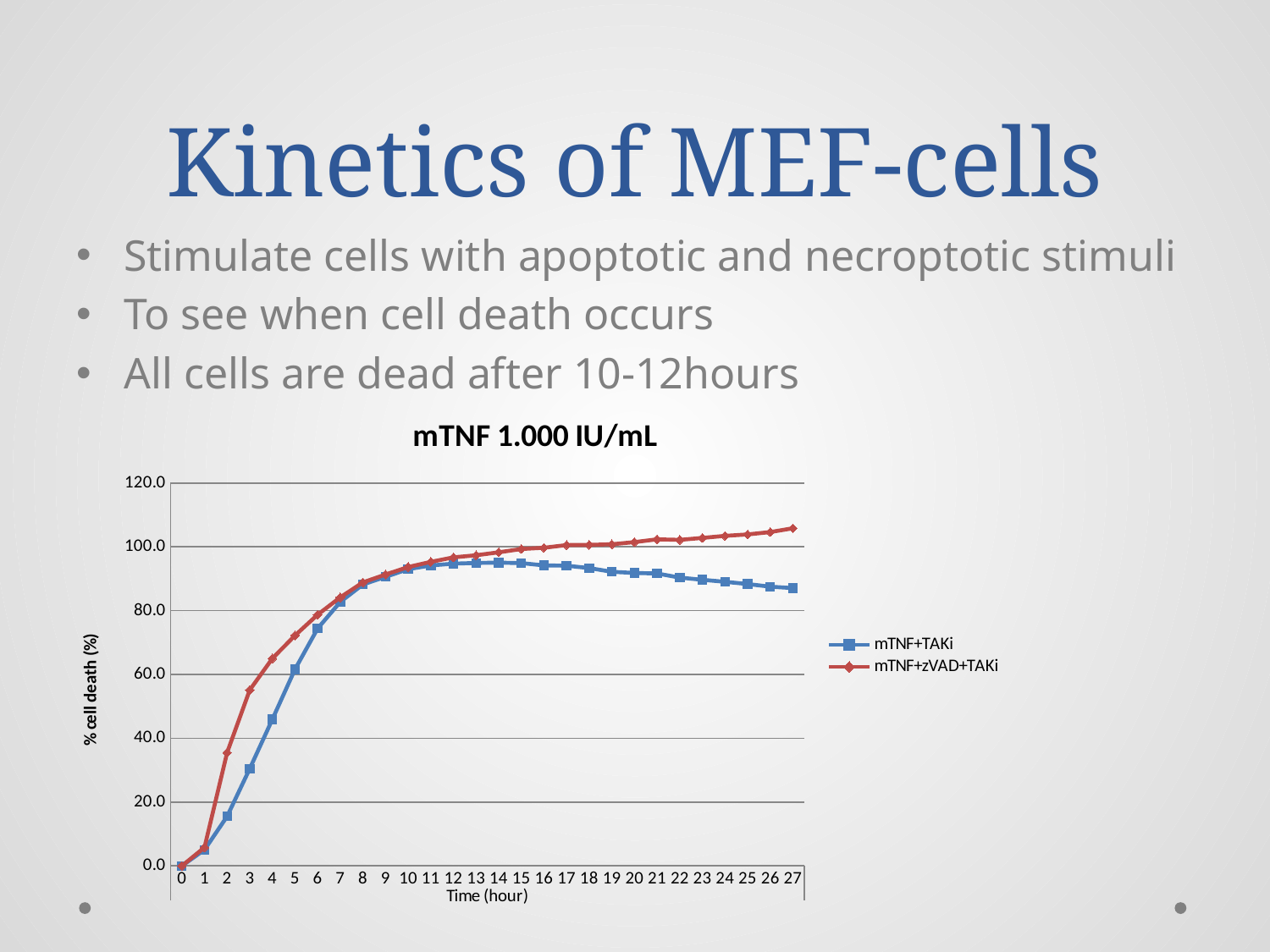
What is the label of the y axis? % cell death (%) What is the title of the chart? mTNF 1.000 IU/mL What kind of chart is shown on the slide? line chart Is the value for mTNF+TAKi at hour 27 greater or less than 100.0? less At hour 3, which series has the higher % cell death, mTNF+TAKi or mTNF+zVAD+TAKi? mTNF+zVAD+TAKi Does the mTNF+TAKi series rise or fall between hour 14 and hour 27? fall How many series does the legend list? 2 Is the value for mTNF+TAKi at hour 3 greater or less than 40.0? less Does the mTNF+zVAD+TAKi series rise or fall from hour 0 to hour 27? rise How many time points are plotted along the x axis? 28 Is the value for mTNF+zVAD+TAKi at hour 27 greater or less than 100.0? greater